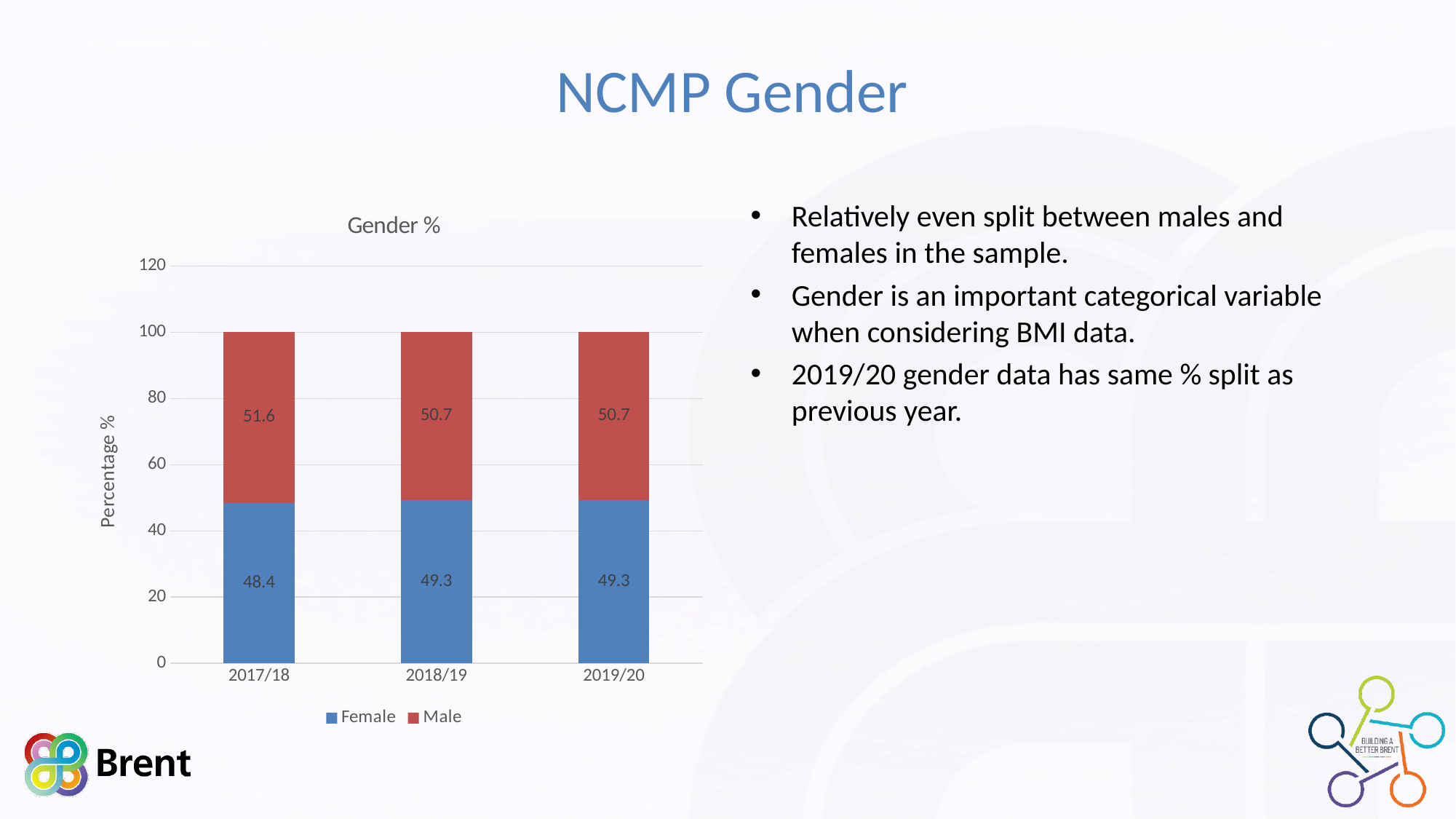
What is the difference between the Male and Female values in 2017/18? 3.2 In 2019/20, which is larger, the Male value or the Female value? Male What kind of chart is shown? Stacked bar chart What is the Male value for 2018/19? 50.7 Which year has the lowest Female value? 2017/18 What is the total of the stacked bar for 2018/19? 100 What is the Female value for 2019/20? 49.3 Which year has the highest Male value? 2017/18 What is the Male value for 2017/18? 51.6 What is the Female value for 2017/18? 48.4 How many series does the legend list? 2 How many years are shown on the x axis? 3